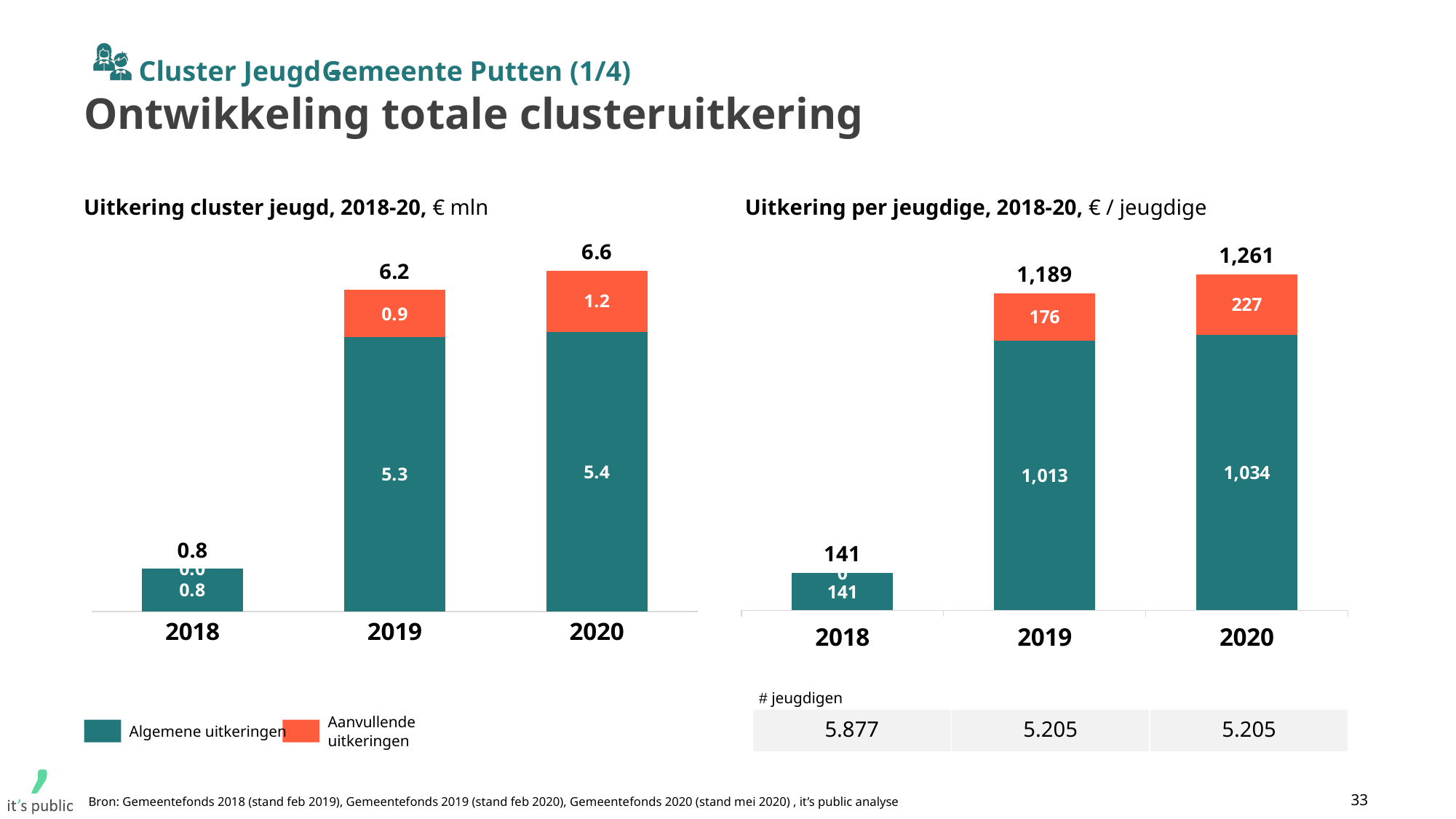
In the right chart 'Uitkering per jeugdige, 2018-20', what is the value of Algemene uitkeringen for 2020? 1,034 In the left chart 'Uitkering cluster jeugd, 2018-20', which year has the lowest total? 2018 In the left chart 'Uitkering cluster jeugd, 2018-20', what is the total of the stacked bar for 2020? 6.6 In the right chart 'Uitkering per jeugdige, 2018-20', which year has the highest total? 2020 What kind of chart is the right chart 'Uitkering per jeugdige, 2018-20'? stacked bar chart How many series does the legend list for the left chart 'Uitkering cluster jeugd, 2018-20'? 2 In the right chart 'Uitkering per jeugdige, 2018-20', what is the total for 2019? 1,189 In the left chart 'Uitkering cluster jeugd, 2018-20', what is the value of Algemene uitkeringen for 2019? 5.3 In the left chart 'Uitkering cluster jeugd, 2018-20', what is the difference between the totals for 2020 and 2019? 0.4 In the right chart 'Uitkering per jeugdige, 2018-20', what is the value of Aanvullende uitkeringen for 2019? 176 In the left chart 'Uitkering cluster jeugd, 2018-20', what is the value of Aanvullende uitkeringen for 2020? 1.2 In the right chart 'Uitkering per jeugdige, 2018-20', do the totals rise or fall from 2018 to 2020? rise